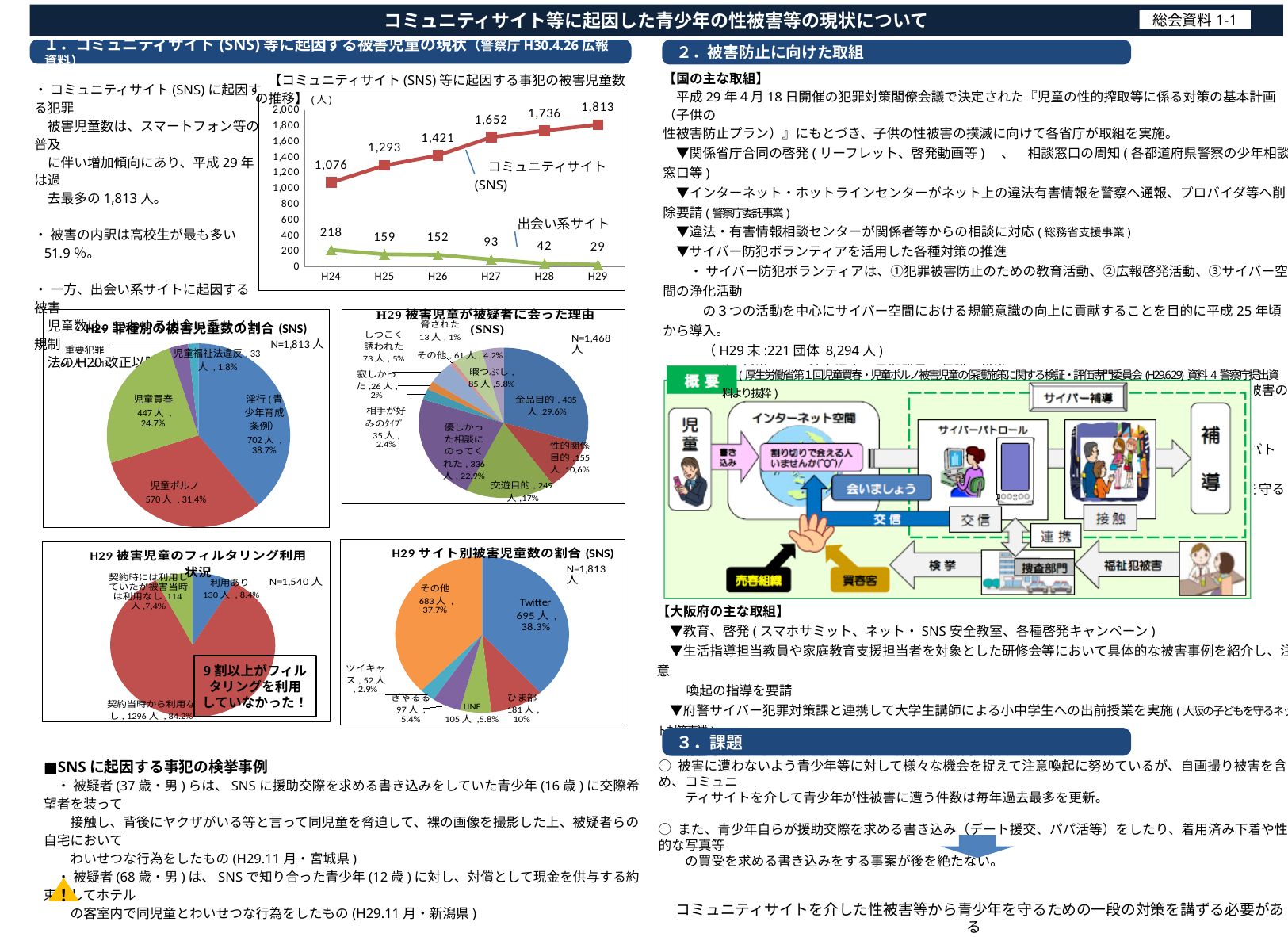
In the pie chart H29 サイト別被害児童数の割合(SNS), how many people are in the Twitter category? 695人 In the pie chart H29 被害児童が被疑者に会った理由(SNS), how many people are in the 金品目的 category? 435人 In the pie chart H29 罪種別の被害児童数の割合(SNS), what share does 児童ポルノ have? 31.4% In the pie chart H29 被害児童のフィルタリング利用状況, what share does 契約当時から利用なし have? 84.2% In the pie chart H29 被害児童が被疑者に会った理由(SNS), which is larger, 交遊目的 or 性的関係目的? 交遊目的 In the line chart 【コミュニティサイト(SNS)等に起因する事犯の被害児童数の推移】, does the 出会い系サイト series rise or fall from H24 to H29? fall In the line chart 【コミュニティサイト(SNS)等に起因する事犯の被害児童数の推移】, in which year is the コミュニティサイト(SNS) value lowest? H24 In the line chart 【コミュニティサイト(SNS)等に起因する事犯の被害児童数の推移】, what is the difference between the コミュニティサイト(SNS) values in H29 and H24? 737 In the pie chart H29 罪種別の被害児童数の割合(SNS), which category has the largest share? 淫行(青少年育成条例) In the line chart 【コミュニティサイト(SNS)等に起因する事犯の被害児童数の推移】, what is the value for コミュニティサイト(SNS) in H29? 1,813 In the line chart 【コミュニティサイト(SNS)等に起因する事犯の被害児童数の推移】, what is the value for 出会い系サイト in H24? 218 In the line chart 【コミュニティサイト(SNS)等に起因する事犯の被害児童数の推移】, how many years are shown on the x axis? 6